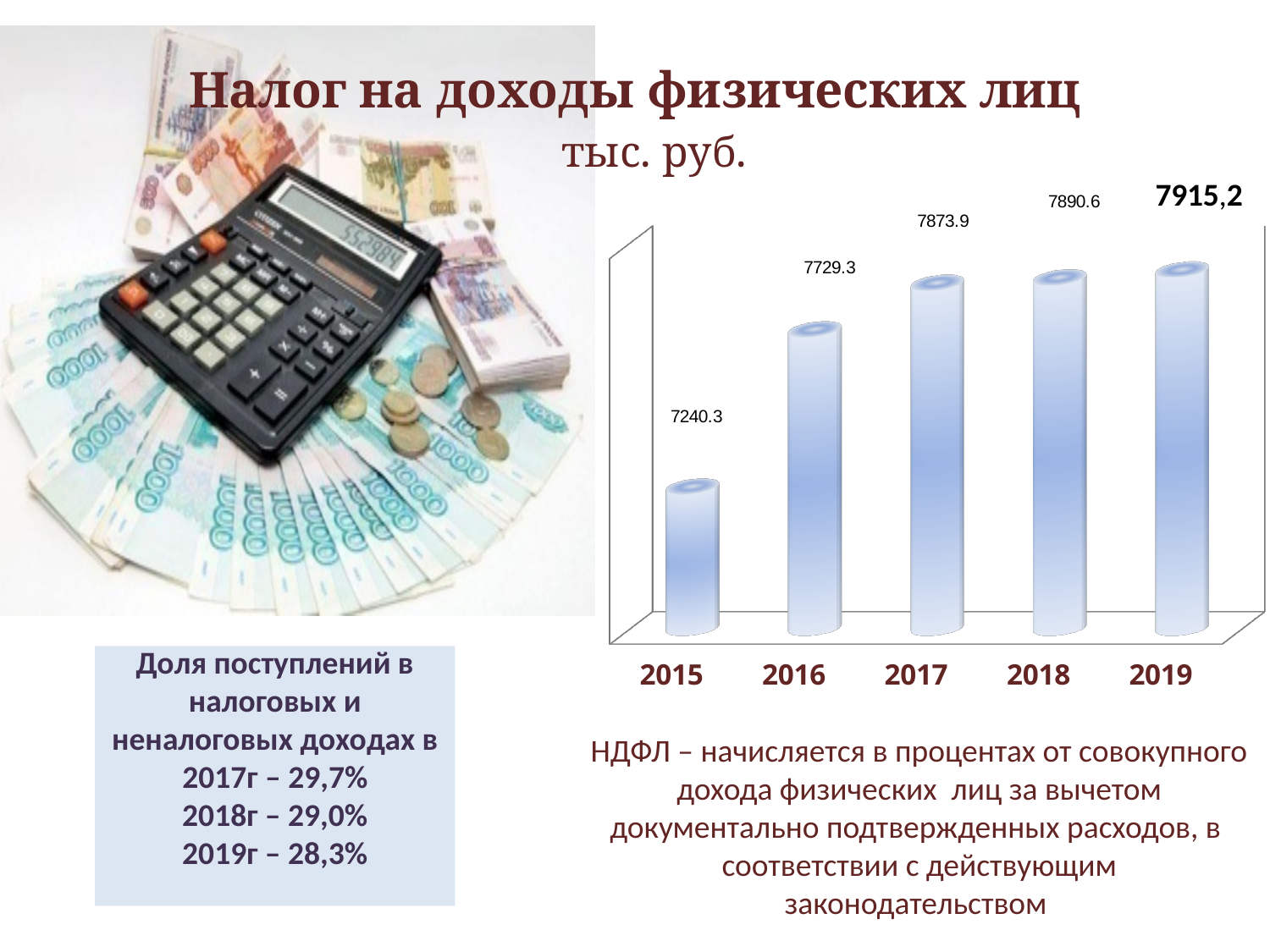
Which is larger, the value for 2016 or the value for 2017? 2017 Which year has the highest value? 2019 What is the value for 2019? 7915,2 What is the value for 2015? 7240.3 Which year has the lowest value? 2015 How many years are shown on the chart? 5 What is the value for 2016? 7729.3 What is the value for 2017? 7873.9 What is the value for 2018? 7890.6 What kind of chart is shown on the slide? bar chart Do the values rise or fall from 2015 to 2019? rise What is the difference between the values for 2016 and 2015? 489.0